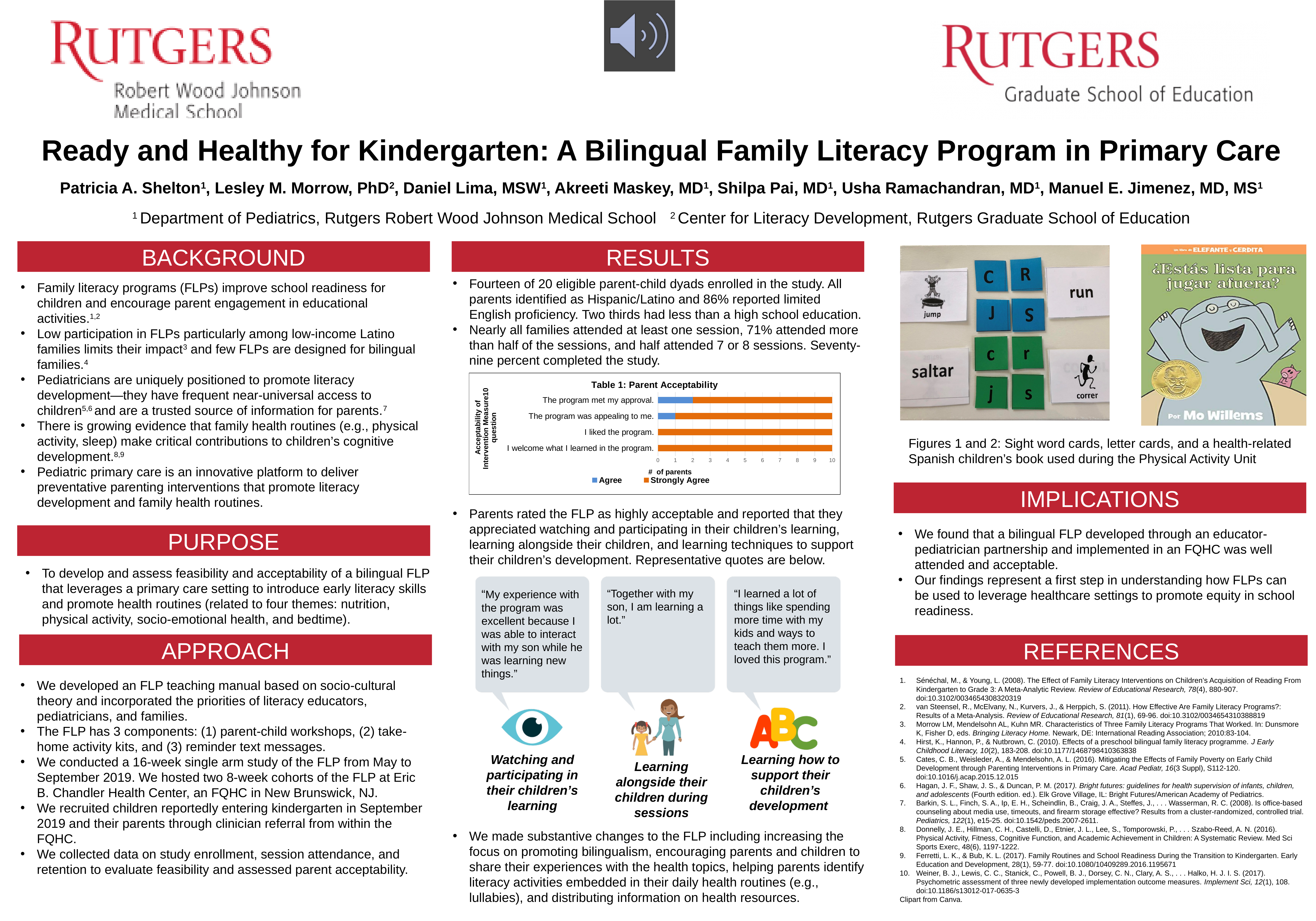
In the "Table 1: Parent Acceptability" chart, is the Strongly Agree value for "I liked the program." greater or less than 5? greater What is the x-axis label of the "Table 1: Parent Acceptability" chart? # of parents In the "Table 1: Parent Acceptability" chart, is the Agree value for "The program was appealing to me." greater or less than 3? less How many series does the legend of the "Table 1: Parent Acceptability" chart list? 2 In the "Table 1: Parent Acceptability" chart, which statement has the largest Agree segment? The program met my approval. In the "Table 1: Parent Acceptability" chart, which statement has the smallest Strongly Agree segment? The program met my approval. What are the two series named in the legend of the "Table 1: Parent Acceptability" chart? Agree and Strongly Agree In the "Table 1: Parent Acceptability" chart, is the Strongly Agree value for "The program was appealing to me." greater or less than 5? greater In the "Table 1: Parent Acceptability" chart, is the Strongly Agree segment larger for "I liked the program." or for "The program met my approval."? I liked the program. How many statements (categories) are plotted in the "Table 1: Parent Acceptability" chart? 4 What kind of chart is shown under the title "Table 1: Parent Acceptability"? bar chart